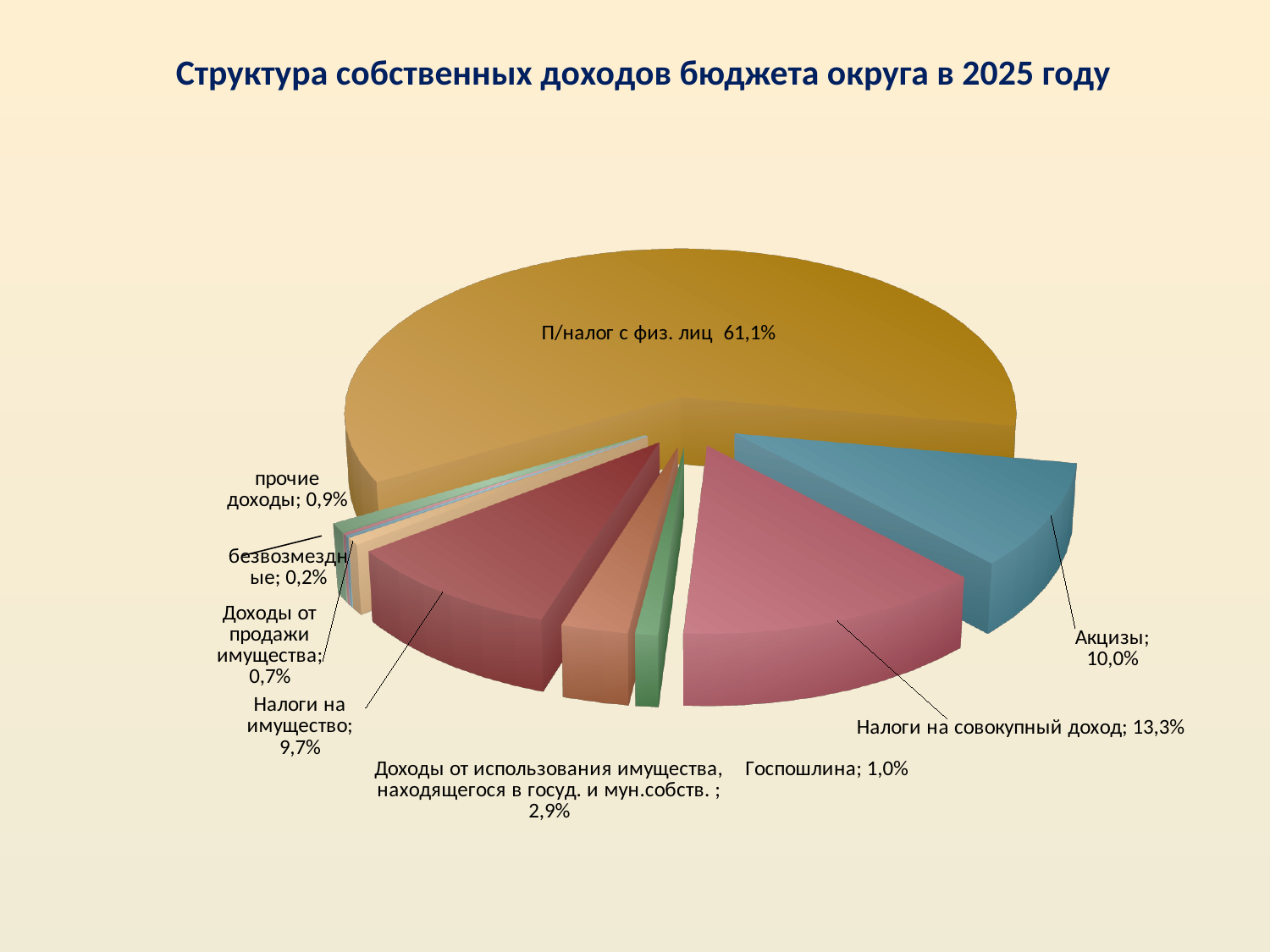
Which is larger: the share of Акцизы or the share of Налоги на имущество? Акцизы What is the share of Налоги на совокупный доход? 13,3% What is the share of Акцизы in the pie chart? 10,0% How many categories are shown in the pie chart? 10 What is the share of П/налог с физ. лиц in the pie chart? 61,1% What is the share of безвозмездные? 0,2% What is the share of Налоги на имущество? 9,7% Which category has the largest share of the pie? П/налог с физ. лиц What is the share of Госпошлина? 1,0% What kind of chart is shown on the slide? Pie chart What is the difference between the shares of Налоги на совокупный доход and Акцизы? 3,3%